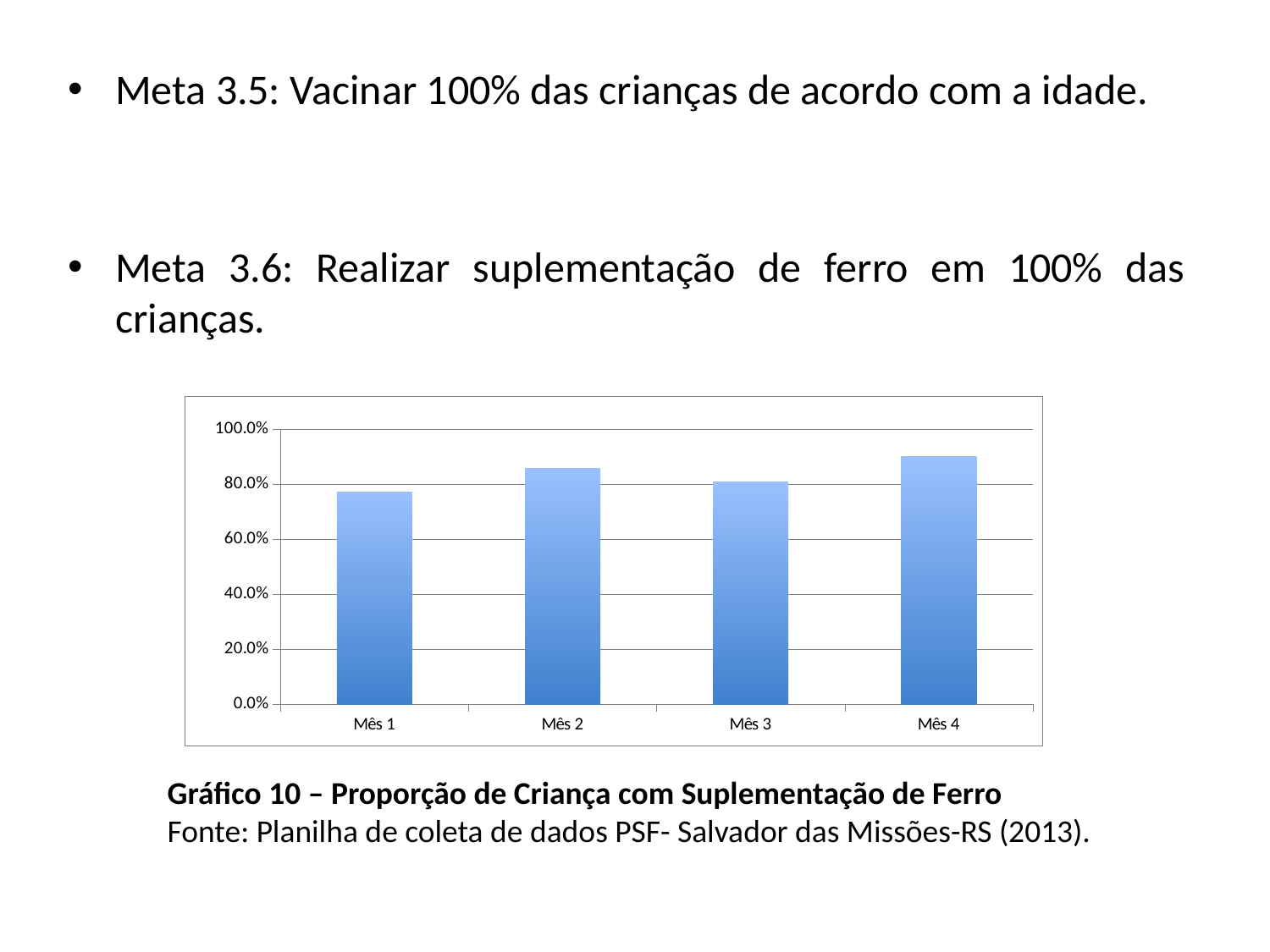
Is the value for Mês 4 greater or less than 100.0%? less Is the value for Mês 2 greater or less than 80.0%? greater Which month has the highest proportion of children with iron supplementation? Mês 4 How many months (categories) are plotted on the chart? 4 Which is larger, the value for Mês 1 or the value for Mês 3? Mês 3 Which is larger, the value for Mês 2 or the value for Mês 3? Mês 2 What kind of chart is shown on the slide? Bar chart Is the value for Mês 1 greater or less than 80.0%? less What is the highest value shown on the vertical axis of the chart? 100.0% What is the title given for the chart (Gráfico 10)? Proporção de Criança com Suplementação de Ferro Which month has the lowest proportion of children with iron supplementation? Mês 1 Does the value rise or fall from Mês 1 to Mês 2? rise